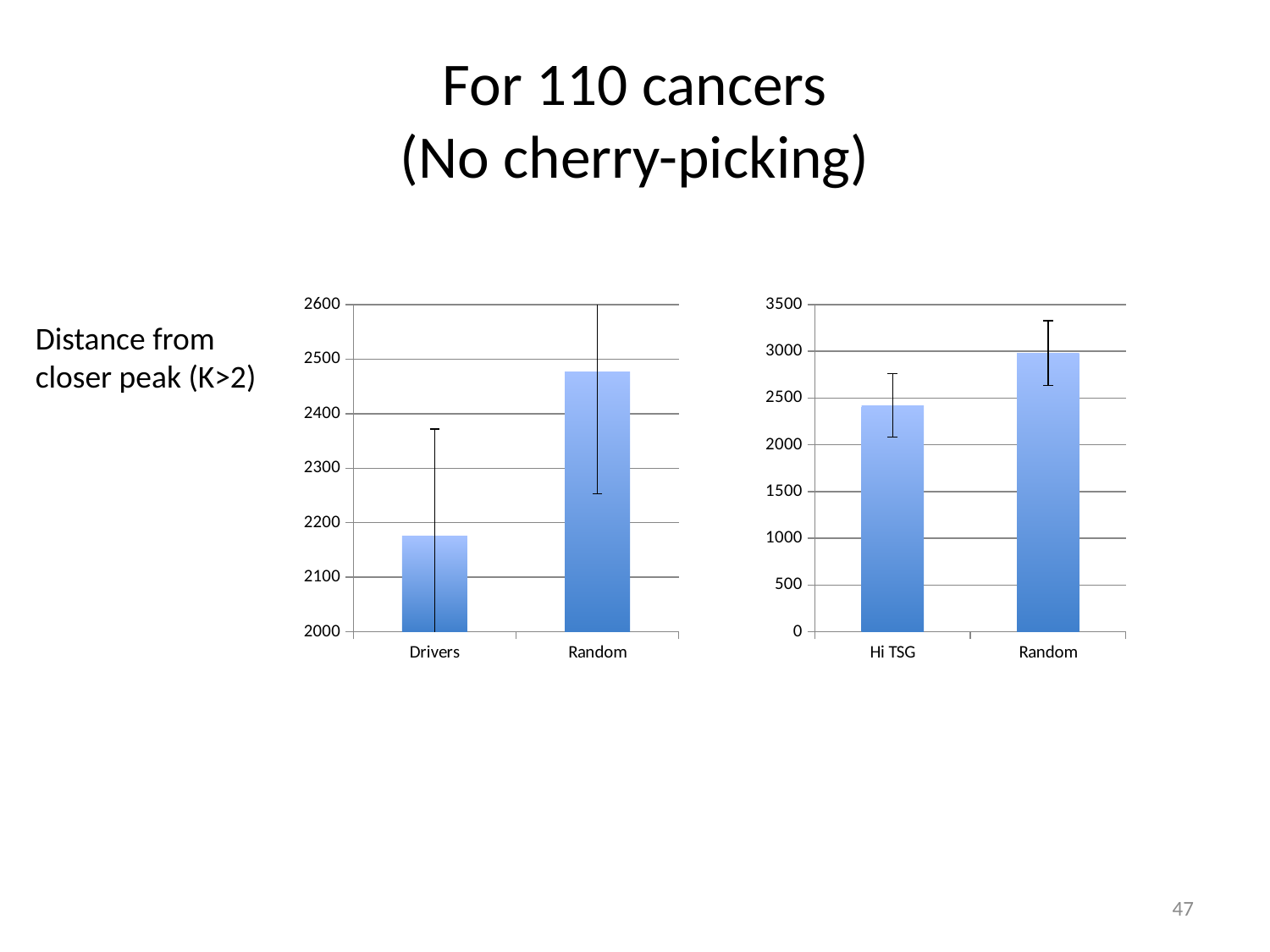
What kind of chart is the left chart? bar chart How many categories are shown in the right chart? 2 In the left chart, is the value for Random greater or less than 2500? less In the left chart (Drivers vs Random), which category has the higher bar? Random In the left chart, is the value for Drivers greater or less than 2200? less What is the lowest value shown on the y axis of the left chart? 2000 In the right chart, is the value for Hi TSG greater or less than 2500? less In the right chart (Hi TSG vs Random), which category has the higher bar? Random In the left chart (Drivers vs Random), which category has the lower bar? Drivers